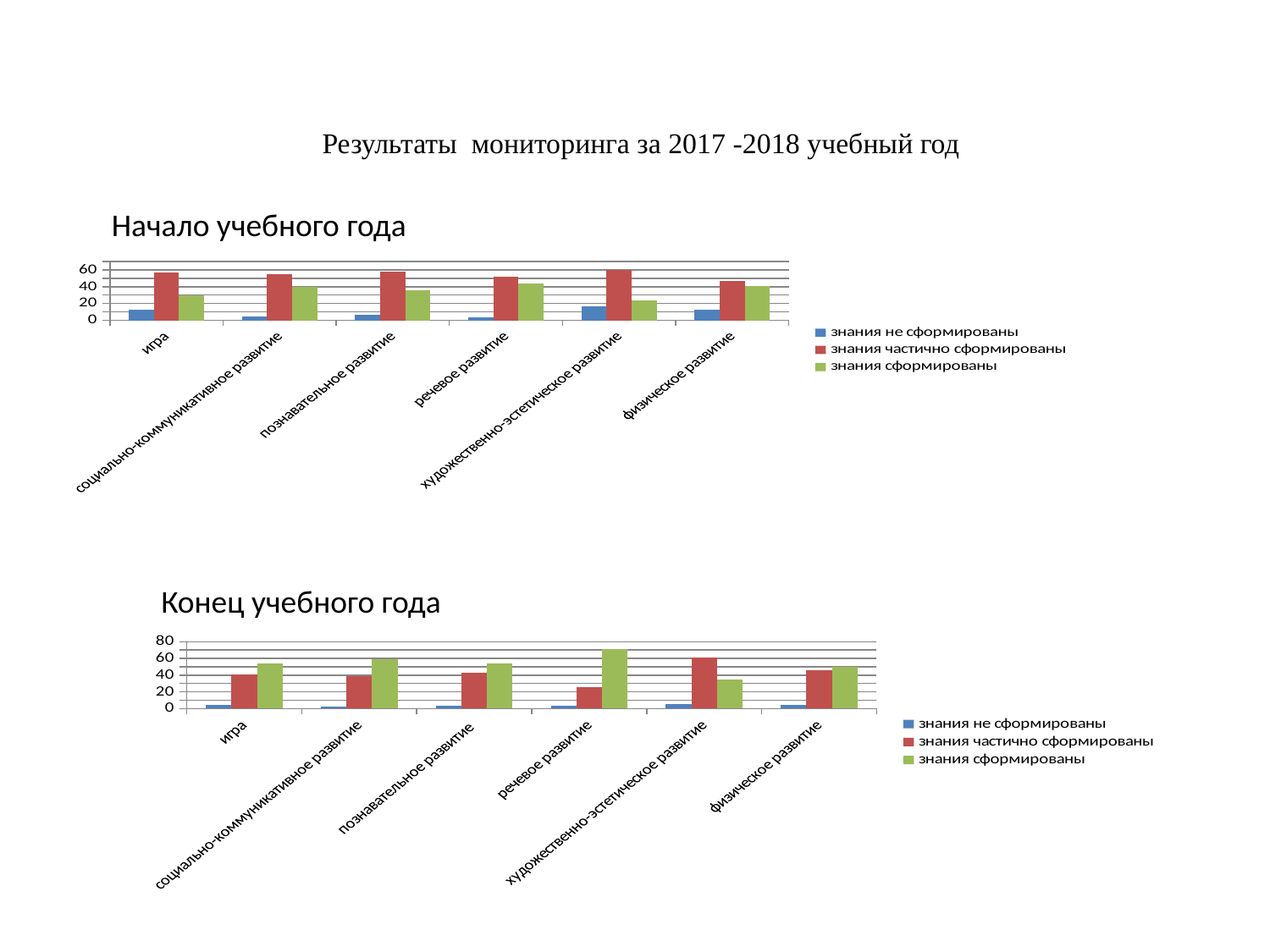
In the 'Начало учебного года' chart, for 'игра', which is larger: 'знания частично сформированы' or 'знания сформированы'? знания частично сформированы In the 'Конец учебного года' chart, is the value of 'знания сформированы' for 'речевое развитие' greater or less than 60? greater What kind of chart is the 'Начало учебного года' chart? bar chart In the 'Конец учебного года' chart, is the value of 'знания частично сформированы' for 'речевое развитие' greater or less than 40? less How many categories are shown on the x axis of the 'Конец учебного года' chart? 6 In the 'Конец учебного года' chart, which category has the lowest value for 'знания частично сформированы'? речевое развитие In the 'Конец учебного года' chart, for 'речевое развитие', which is larger: 'знания частично сформированы' or 'знания сформированы'? знания сформированы In the 'Конец учебного года' chart, which category has the highest value for 'знания сформированы'? речевое развитие What colour represents the series 'знания не сформированы' in the charts? blue In the 'Начало учебного года' chart, is the value of 'знания частично сформированы' for 'игра' greater or less than 40? greater In the 'Начало учебного года' chart, which category has the lowest value for 'знания сформированы'? художественно-эстетическое развитие How many series does the legend of the 'Начало учебного года' chart list? 3